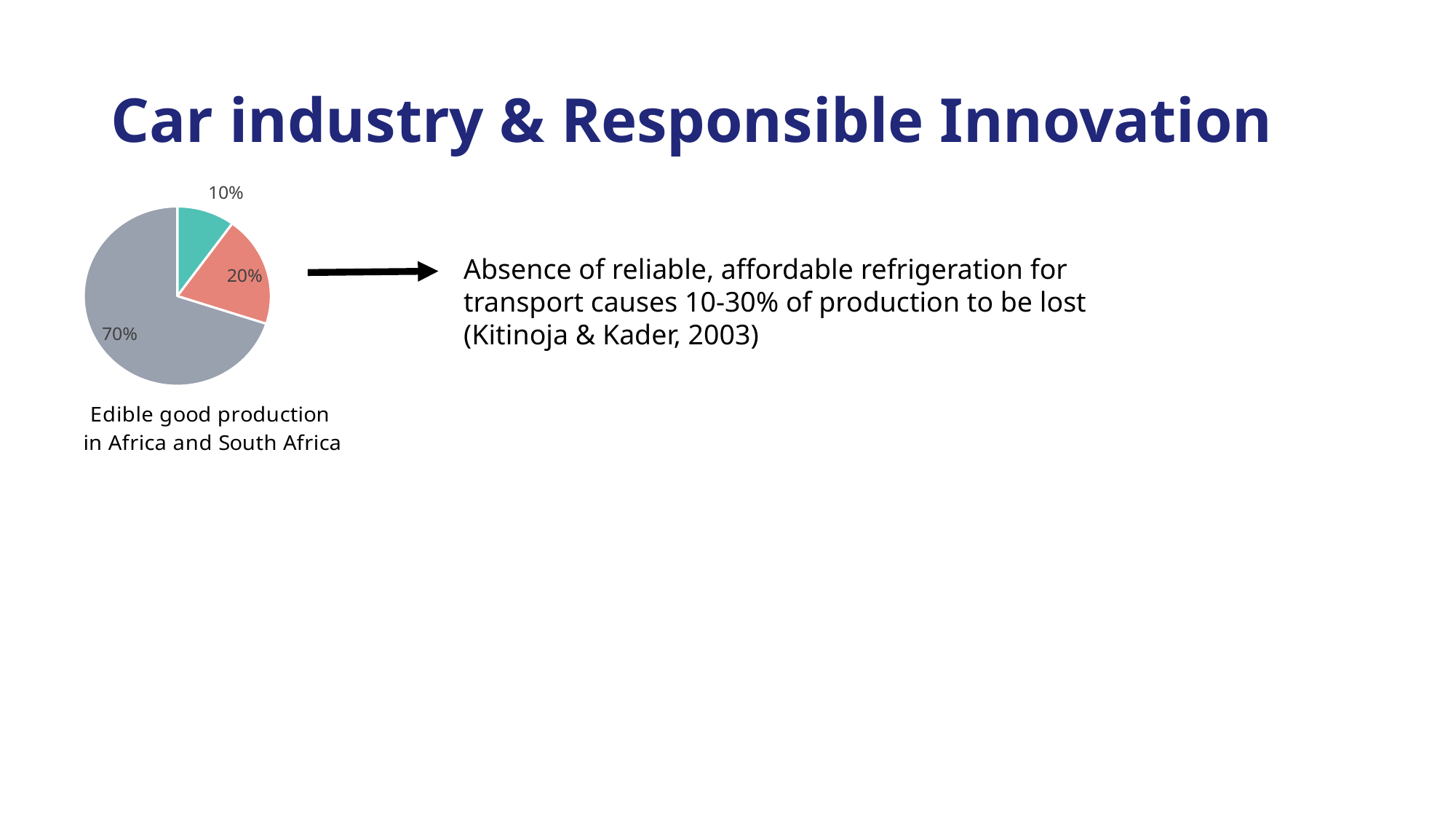
What percentage is shown for the teal slice of the pie chart? 10% What is the value of the largest slice of the pie chart? 70% What percentage is shown for the grey slice of the pie chart? 70% What is the difference between the largest and smallest slices of the pie chart? 60% What colour is the largest slice of the pie chart? grey What kind of chart is shown on the slide? pie chart What is the value of the smallest slice of the pie chart? 10% What is the combined share of the teal and red slices of the pie chart? 30% How many slices does the pie chart have? 3 Which slice is larger in the pie chart, the red slice or the teal slice? the red slice What caption appears below the pie chart? Edible good production in Africa and South Africa What percentage is shown for the red slice of the pie chart? 20%